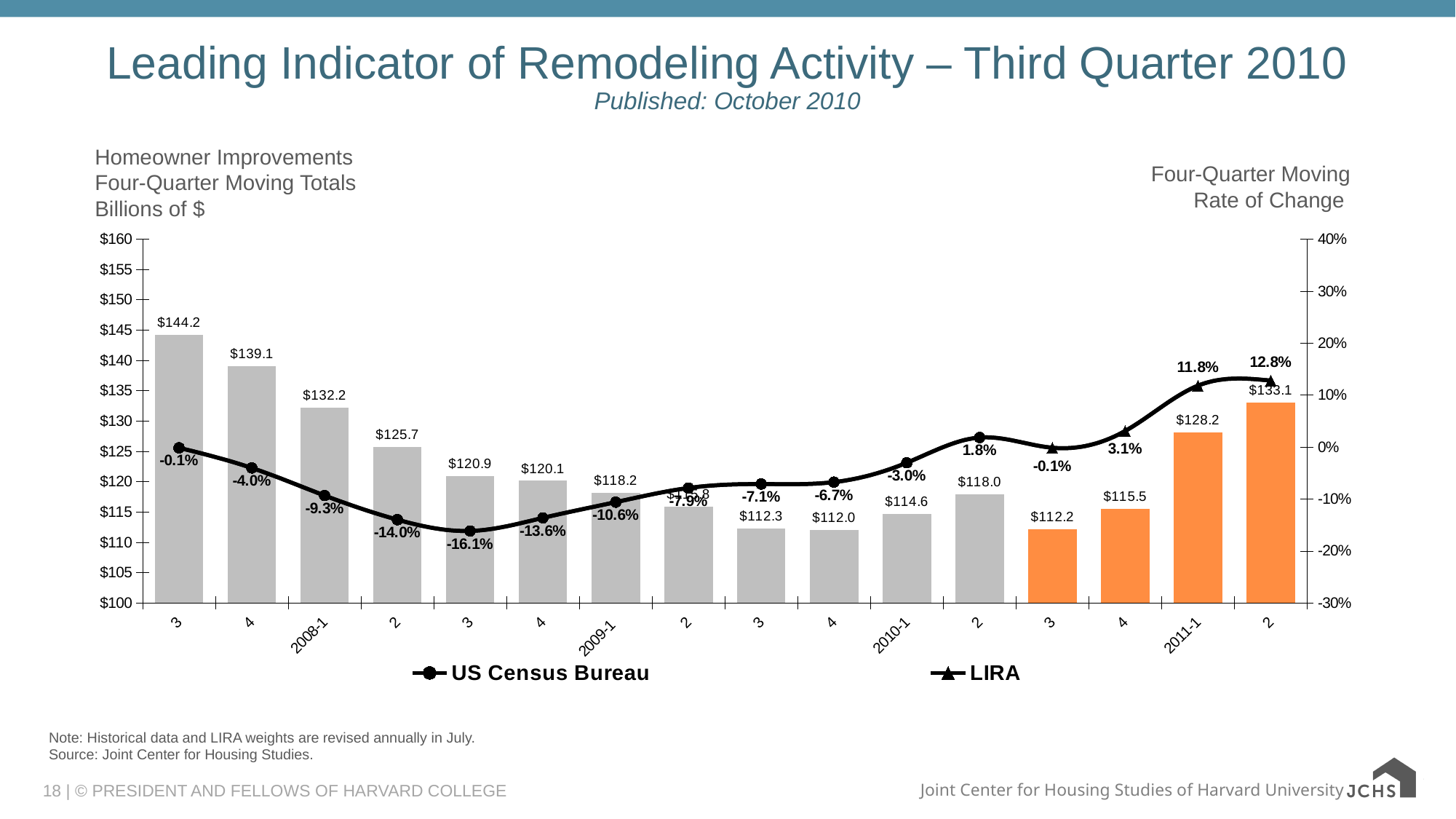
What is the highest four-quarter moving total shown by the bars? $144.2 How many series does the legend list? 2 What is the lowest four-quarter moving rate of change shown on the line? -16.1% What is the difference between the bar values for 2011-2 and 2011-1? $4.9 What is the homeowner improvements four-quarter moving total for 2008-1? $132.2 What is the highest four-quarter moving rate of change shown on the line? 12.8% Do the bar values rise or fall from the first bar (3) through 2009-4? Fall What is the LIRA rate of change shown for 2011-1? 11.8% What kind of chart is shown on the slide? Combination bar and line chart Which has the larger four-quarter moving total, 2010-2 or 2010-4? 2010-2 How many bars are plotted on the chart? 16 What is the four-quarter moving rate of change shown for 2009-1? -10.6%